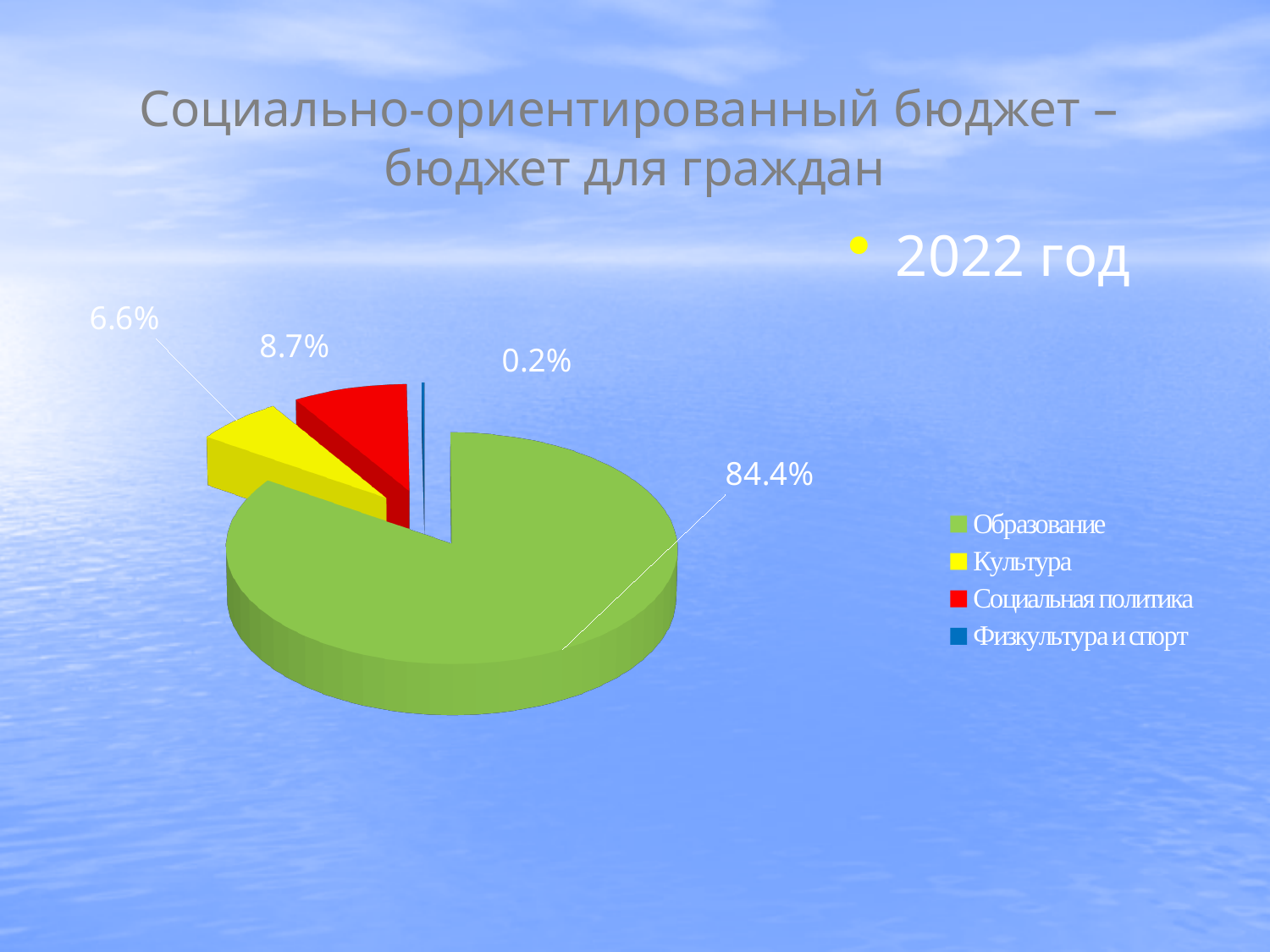
What share of the pie does Образование have? 84.4% How many categories does the pie chart show? 4 What kind of chart is shown on the slide? Pie chart Which year does the chart refer to, according to the text on the slide? 2022 год What share of the pie does Социальная политика have? 8.7% Which category has the smallest slice of the pie? Физкультура и спорт What share of the pie does Физкультура и спорт have? 0.2% What colour is the slice for Культура? Yellow What is the difference between the shares of Социальная политика and Культура? 2.1% Which is larger, the share of Культура or the share of Социальная политика? Социальная политика Which category has the largest slice of the pie? Образование